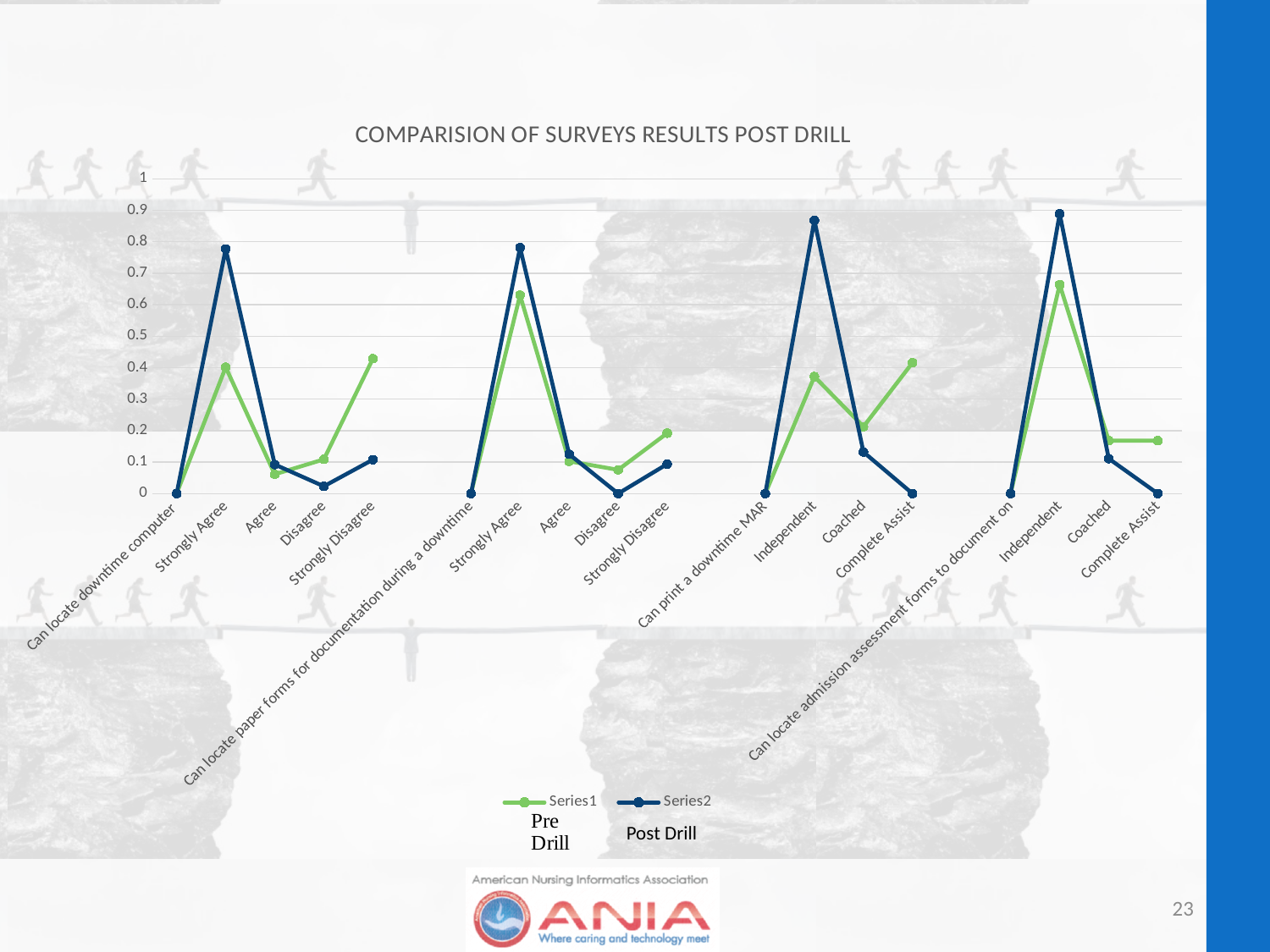
Is the Series2 value for Strongly Agree under 'Can locate downtime computer' greater or less than 0.5? greater What is the title of the chart? COMPARISION OF SURVEYS RESULTS POST DRILL Which series has the larger value for Strongly Agree under 'Can locate paper forms for documentation during a downtime'? Series2 Is the Series2 value for Independent under 'Can print a downtime MAR' greater or less than 0.8? greater Is the Series1 value for Independent under 'Can locate admission assessment forms to document on' greater or less than 0.5? greater What type of chart is shown on the slide? line chart What are the names of the two series in the legend? Series1 and Series2 How many category labels are shown along the x axis? 18 What is the Series2 value for Complete Assist under 'Can locate admission assessment forms to document on'? 0 Which series has the larger value for Strongly Disagree under 'Can locate downtime computer'? Series1 How many series does the legend list? 2